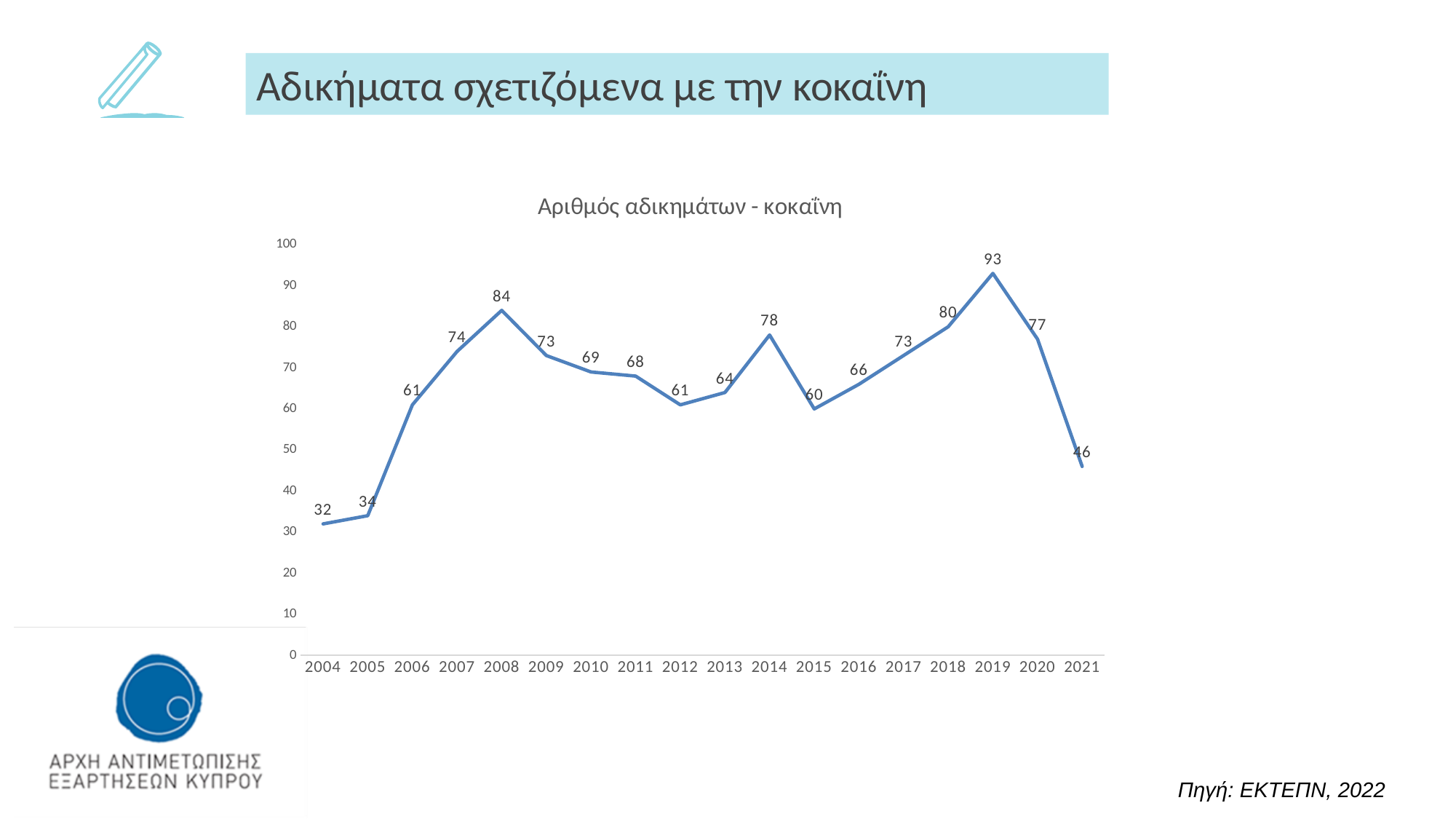
Which year has the highest value? 2019 Do the values rise or fall from 2019 to 2021? fall What is the value for 2021? 46 Which is larger, the value for 2014 or the value for 2018? 2018 How many years are plotted on the x axis? 18 Which year has the lowest value? 2004 What is the value for 2015? 60 What kind of chart is this? line chart What is the difference between the values for 2004 and 2008? 52 What is the difference between the values for 2019 and 2020? 16 What is the title of the chart? Αριθμός αδικημάτων - κοκαΐνη What is the value for 2008? 84